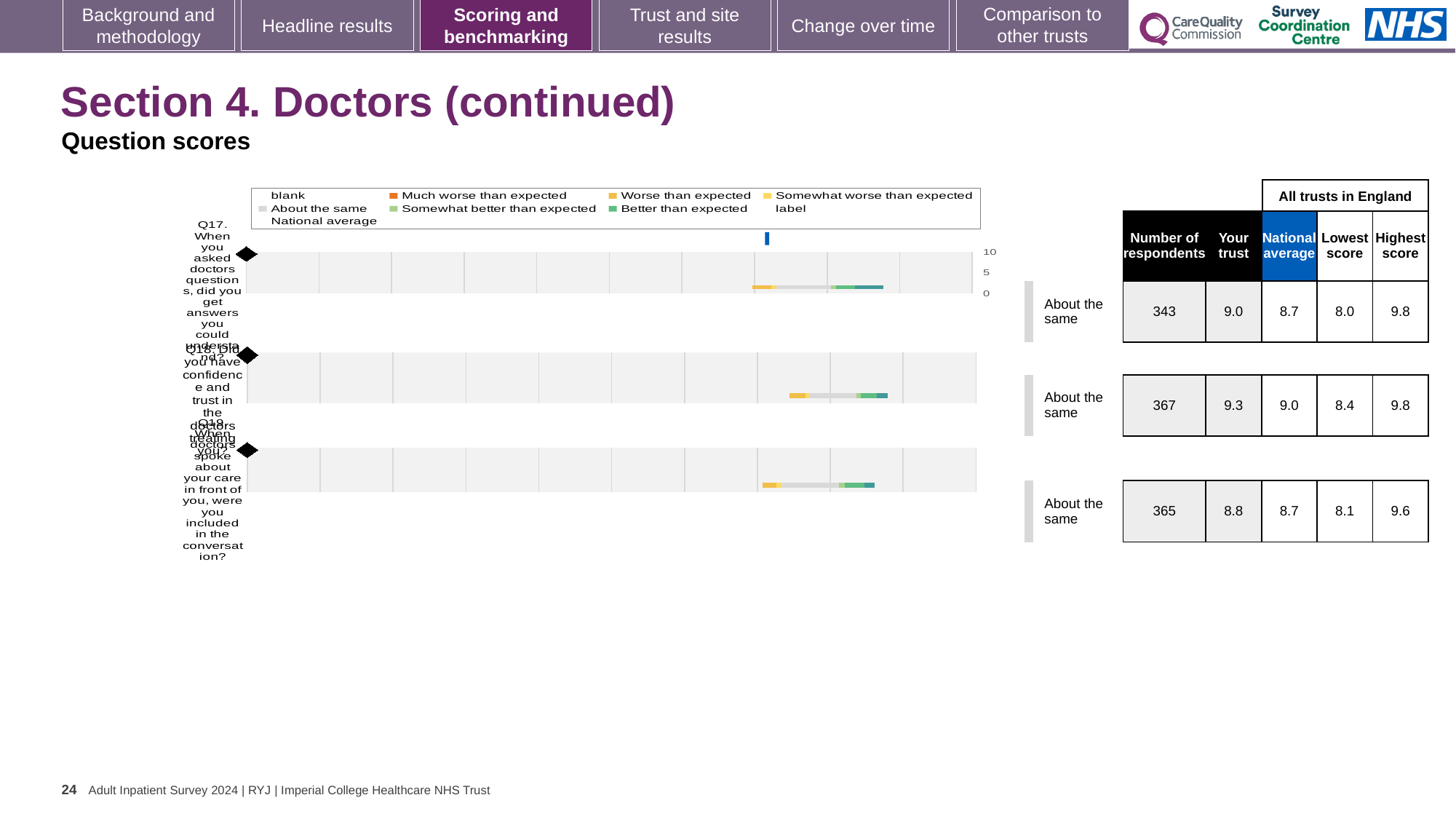
In the table beside the chart, what is the lowest score for Q18? 8.4 In the table beside the chart, what is the highest score for Q19? 9.6 In the table beside the chart, what is the national average for Q19? 8.7 In the table beside the chart, what is the difference between the 'Your trust' score and the national average for Q17? 0.3 In the table beside the chart, which question has the highest 'Your trust' score? Q18 What kind of chart is shown on the slide? bar chart In the table beside the chart, what is the number of respondents for Q17? 343 What is the highest value shown on the chart's axis? 10 How many questions (categories) are plotted in the chart? 3 In the table beside the chart, what is the 'Your trust' score for Q18? 9.3 In the table beside the chart, which question has the fewest respondents? Q17 In the chart legend, what colour represents 'Much worse than expected'? orange